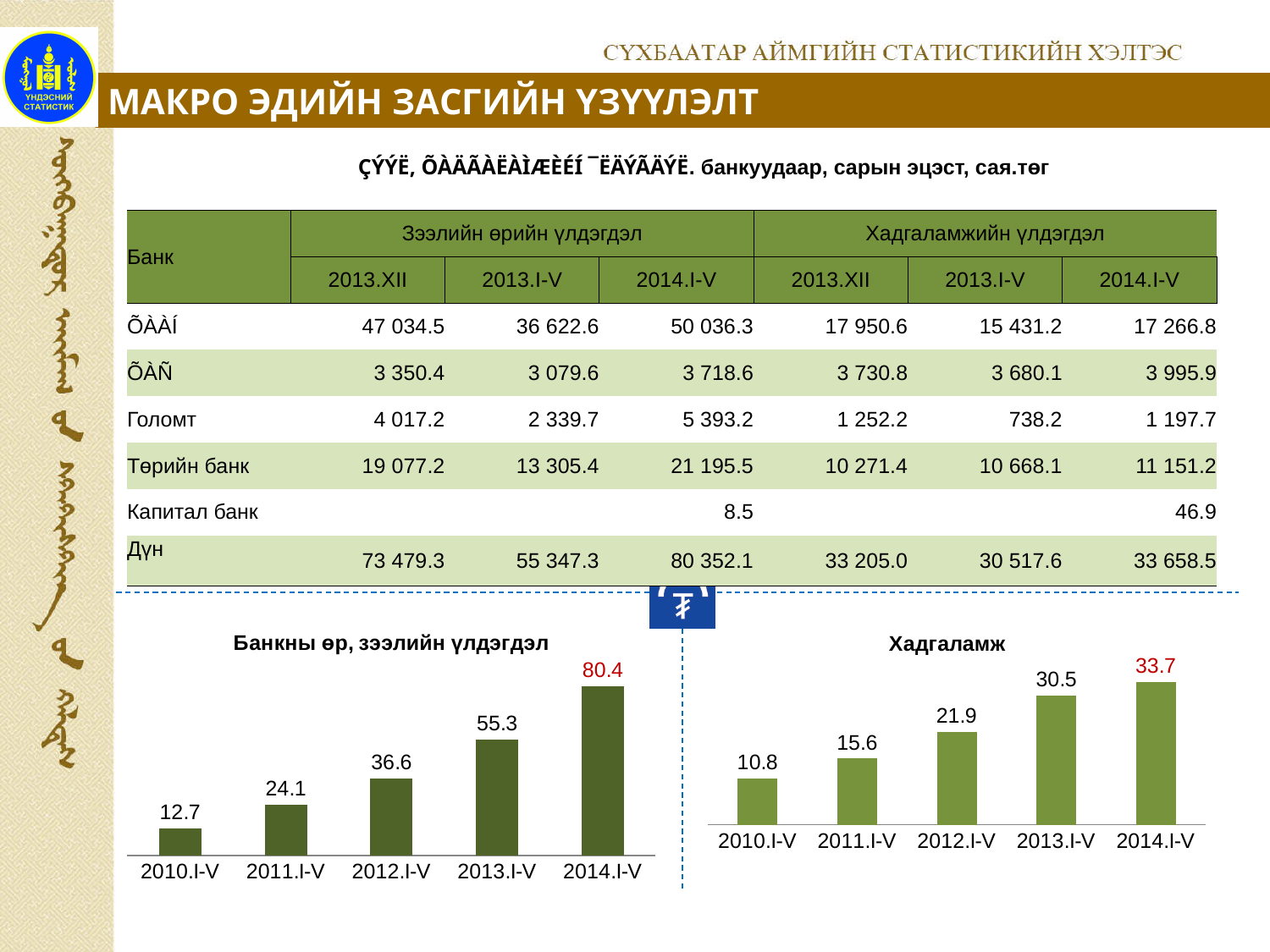
In the 'Хадгаламж' chart, which is larger, the value for 2011.I-V or 2012.I-V? 2012.I-V In the 'Хадгаламж' chart, which period has the highest value? 2014.I-V What kind of chart is the 'Хадгаламж' chart? Bar chart In the 'Хадгаламж' chart, what is the value for 2012.I-V? 21.9 How many bars are in the 'Банкны өр, зээлийн үлдэгдэл' chart? 5 In the 'Банкны өр, зээлийн үлдэгдэл' chart, which period has the lowest value? 2010.I-V In the 'Банкны өр, зээлийн үлдэгдэл' chart, what is the value for 2011.I-V? 24.1 In the 'Банкны өр, зээлийн үлдэгдэл' chart, what is the value for 2014.I-V? 80.4 In the 'Хадгаламж' chart, what is the value for 2010.I-V? 10.8 In the 'Банкны өр, зээлийн үлдэгдэл' chart, what is the difference between the values for 2014.I-V and 2013.I-V? 25.1 In the 'Банкны өр, зээлийн үлдэгдэл' chart, do the values rise or fall from 2010.I-V to 2014.I-V? Rise In the 'Хадгаламж' chart, what is the difference between the values for 2013.I-V and 2012.I-V? 8.6